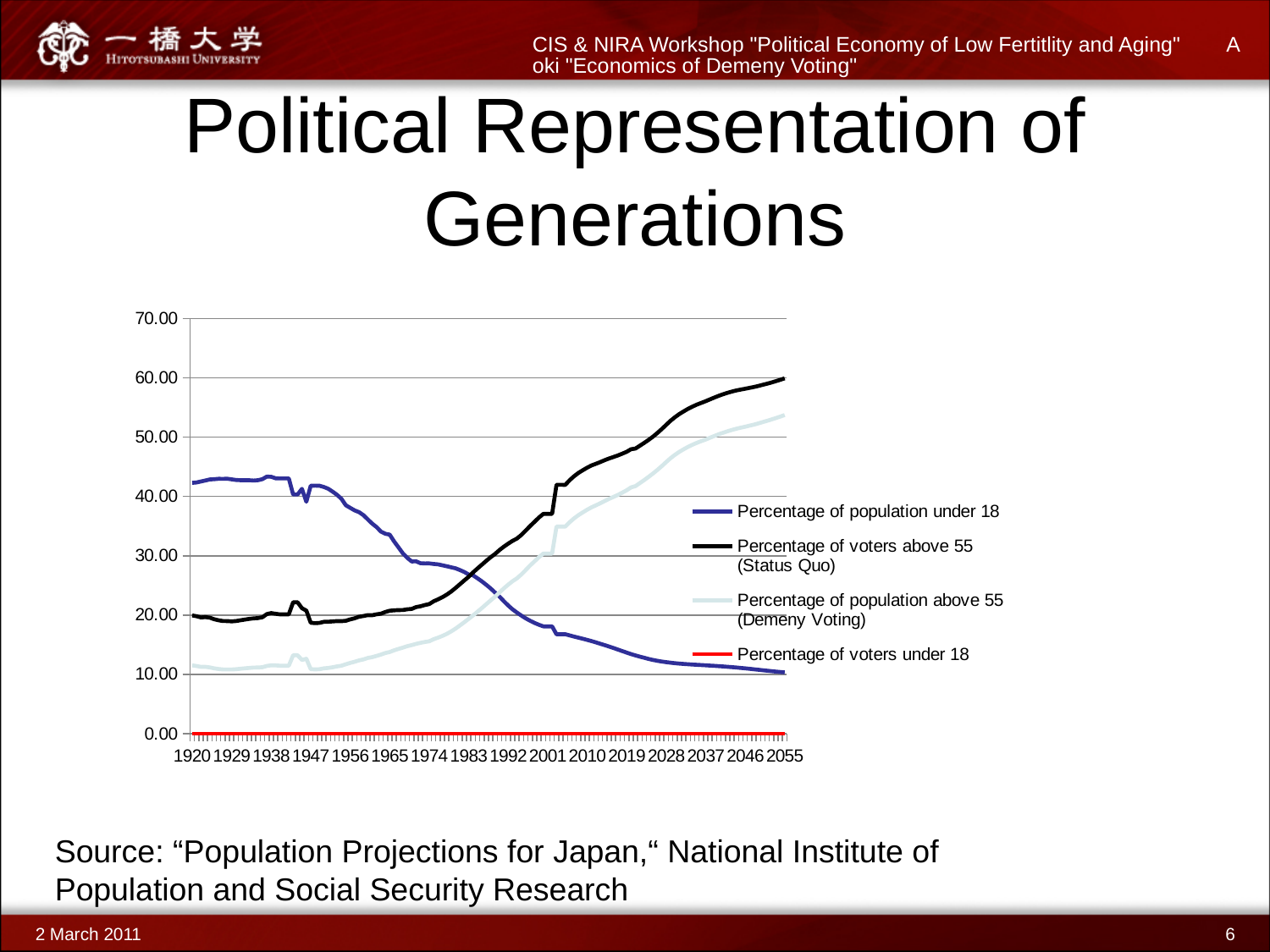
Is the value for 'Percentage of voters under 18' in 2055 greater or less than 10.00? less Does the 'Percentage of population under 18' line rise or fall from 1920 to 2055? Fall Is the value for 'Percentage of population under 18' in 2055 greater or less than 20.00? less In 1920, which is larger: 'Percentage of population under 18' or 'Percentage of voters above 55 (Status Quo)'? Percentage of population under 18 How many year labels are shown on the x axis? 16 How many series does the legend list? 4 Is the value for 'Percentage of population under 18' in 1920 greater or less than 30.00? greater In 2055, which is larger: 'Percentage of voters above 55 (Status Quo)' or 'Percentage of population above 55 (Demeny Voting)'? Percentage of voters above 55 (Status Quo) What kind of chart is shown on the slide? Line chart What colour is the line for 'Percentage of voters under 18'? Red Does the 'Percentage of voters above 55 (Status Quo)' line rise or fall from 1920 to 2055? Rise